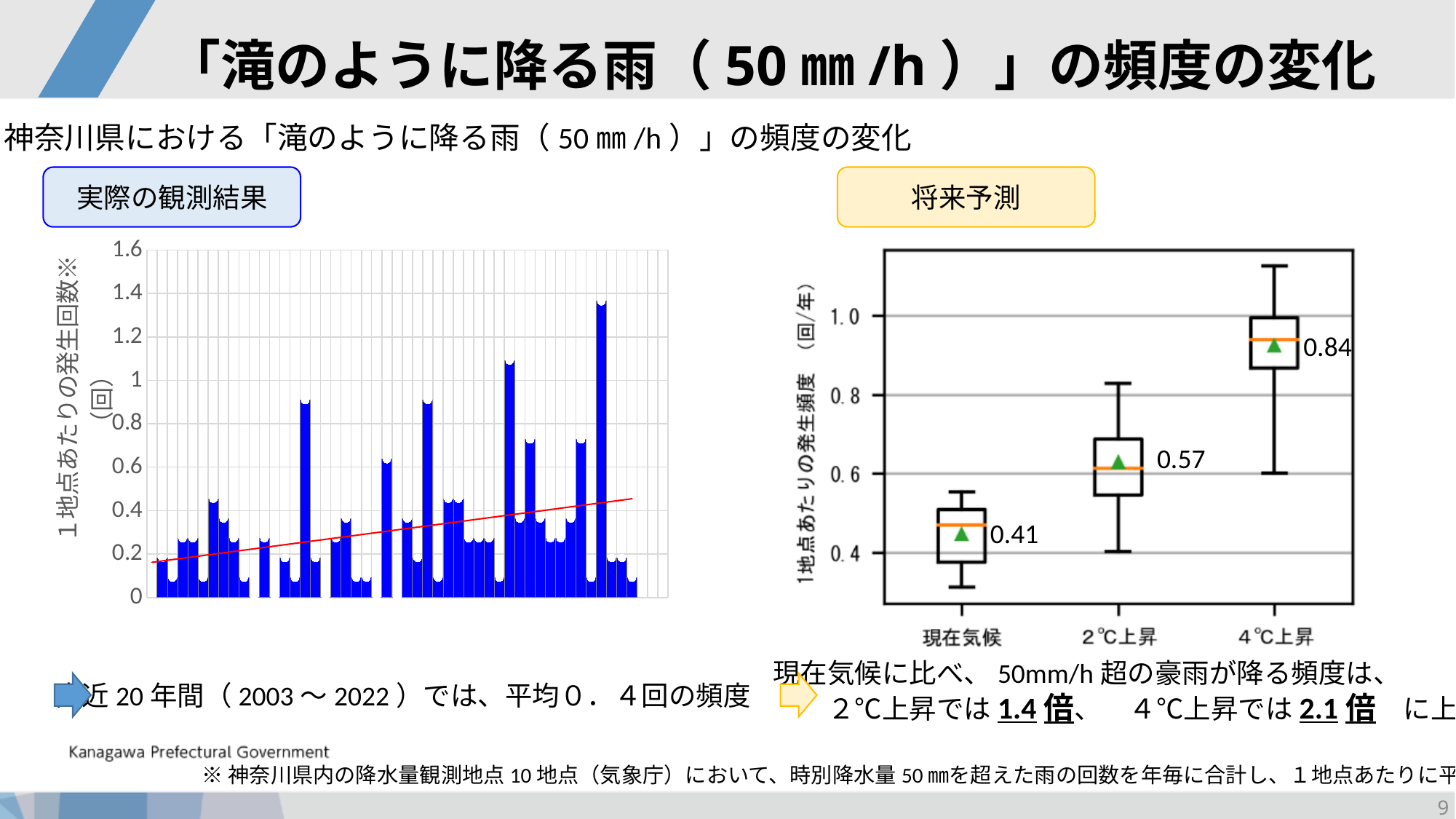
On the right chart (将来予測), which scenario has the lowest labelled value? 現在気候 On the right chart (将来予測), what is the labelled value for 2℃上昇? 0.57 What kind of chart is the left chart (実際の観測結果)? bar chart On the right chart (将来予測), which scenario has the highest labelled value? 4℃上昇 On the right chart (将来予測), what is the difference between the labelled values for 4℃上昇 and 現在気候? 0.43 On the right chart (将来予測), what is the labelled value for 現在気候? 0.41 On the right chart (将来予測), is the top of the upper whisker for 4℃上昇 greater or less than 1.0? greater On the right chart (将来予測), how many climate scenarios are shown on the x axis? 3 On the right chart (将来予測), what is the labelled value for 4℃上昇? 0.84 On the right chart (将来予測), which is larger, the labelled value for 2℃上昇 or for 4℃上昇? 4℃上昇 On the right chart (将来予測), what is the difference between the labelled values for 2℃上昇 and 現在気候? 0.16 On the left chart (実際の観測結果), does the red trend line rise or fall from left to right? rise